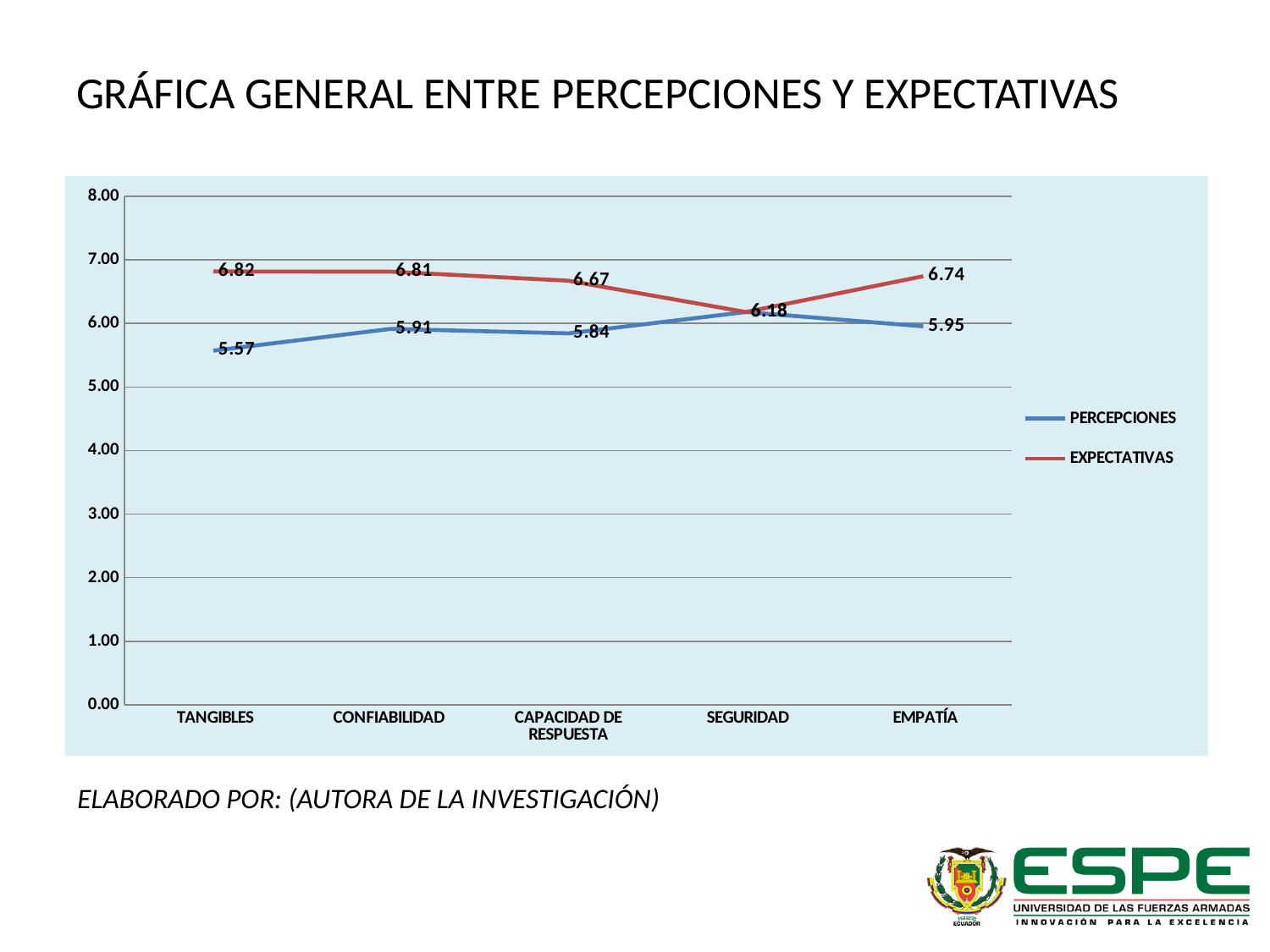
What kind of chart is shown on the slide? line chart Is the PERCEPCIONES value for CAPACIDAD DE RESPUESTA greater or less than 6.00? less For EMPATÍA, which series has the higher value, PERCEPCIONES or EXPECTATIVAS? EXPECTATIVAS Which category has the lowest EXPECTATIVAS value? SEGURIDAD What is the PERCEPCIONES value for CONFIABILIDAD? 5.91 What is the PERCEPCIONES value for EMPATÍA? 5.95 What is the difference between the EXPECTATIVAS and PERCEPCIONES values for TANGIBLES? 1.25 How many categories are shown on the x axis? 5 What colour is the EXPECTATIVAS line? red Which category has the lowest PERCEPCIONES value? TANGIBLES What is the EXPECTATIVAS value for TANGIBLES? 6.82 How many series does the legend list? 2